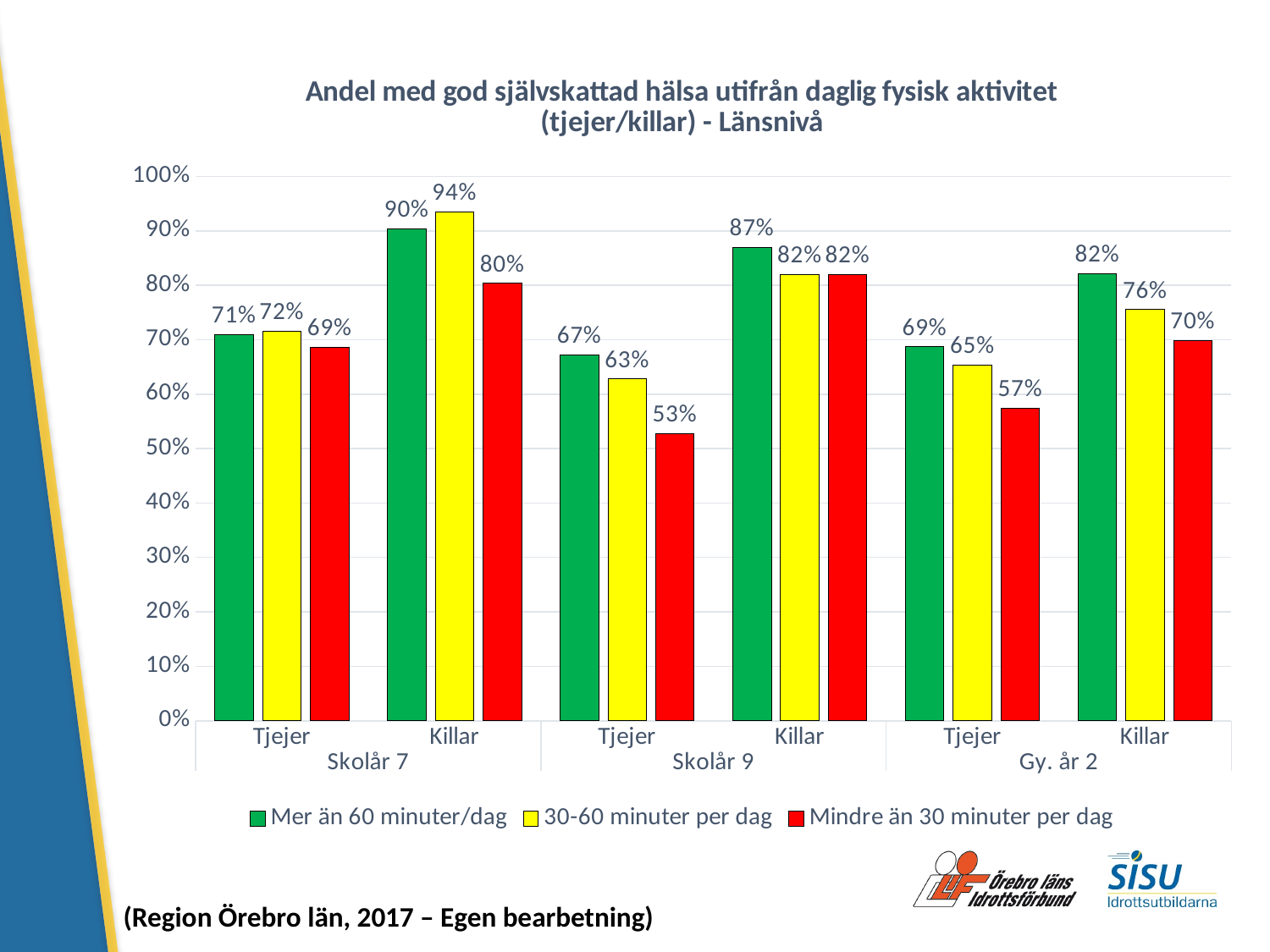
Which group has the lowest value for 'Mindre än 30 minuter per dag'? Tjejer, Skolår 9 Which group has the highest value for '30-60 minuter per dag'? Killar, Skolår 7 What is the value for 'Mer än 60 minuter/dag' among Killar in Skolår 7? 90% How many groups (category bars clusters) are shown on the x axis? 6 What is the difference between 'Mer än 60 minuter/dag' and 'Mindre än 30 minuter per dag' for Tjejer in Skolår 9? 14 percentage points What is the value for 'Mindre än 30 minuter per dag' among Tjejer in Skolår 9? 53% How many series does the legend list? 3 What kind of chart is shown on the slide? Bar chart Which is larger for Tjejer in Gy. år 2: 'Mer än 60 minuter/dag' or '30-60 minuter per dag'? Mer än 60 minuter/dag Which colour represents 'Mindre än 30 minuter per dag' in the legend? Red Is the value for 'Mindre än 30 minuter per dag' among Killar in Skolår 9 greater or less than 80%? greater What is the value for '30-60 minuter per dag' among Killar in Gy. år 2? 76%